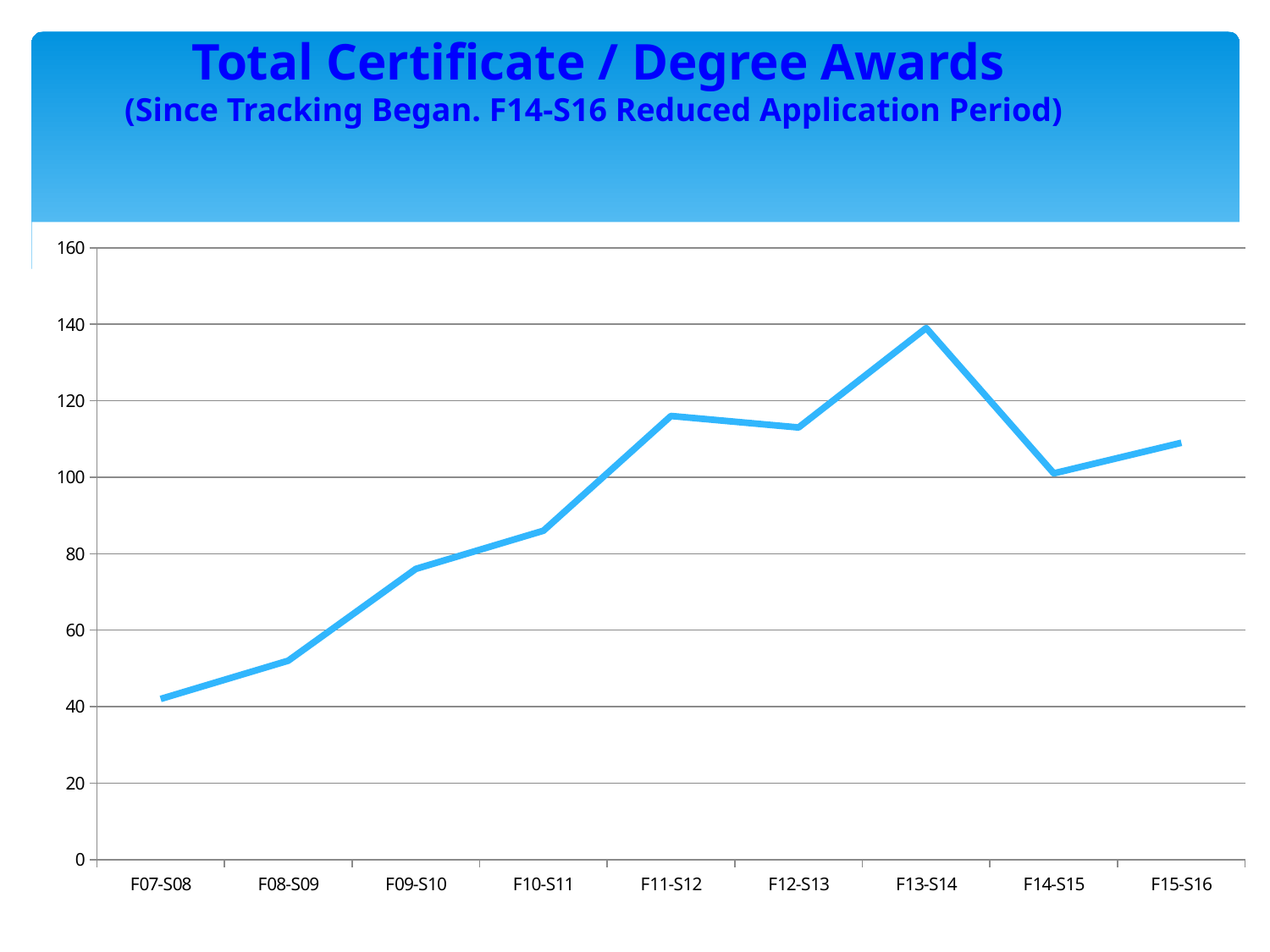
How many academic-year periods are plotted along the x axis? 9 Do the values rise or fall from F07-S08 to F13-S14 overall? Rise Is the value for F07-S08 greater or less than 60? less Which period has the highest number of awards? F13-S14 What is the title of the chart? Total Certificate / Degree Awards What kind of chart is shown on the slide? Line chart Which period has the lowest number of awards? F07-S08 Is the value for F13-S14 greater or less than 120? greater Which is larger, the value for F08-S09 or the value for F09-S10? F09-S10 Is the value for F14-S15 greater or less than 120? less Which is larger, the value for F13-S14 or the value for F14-S15? F13-S14